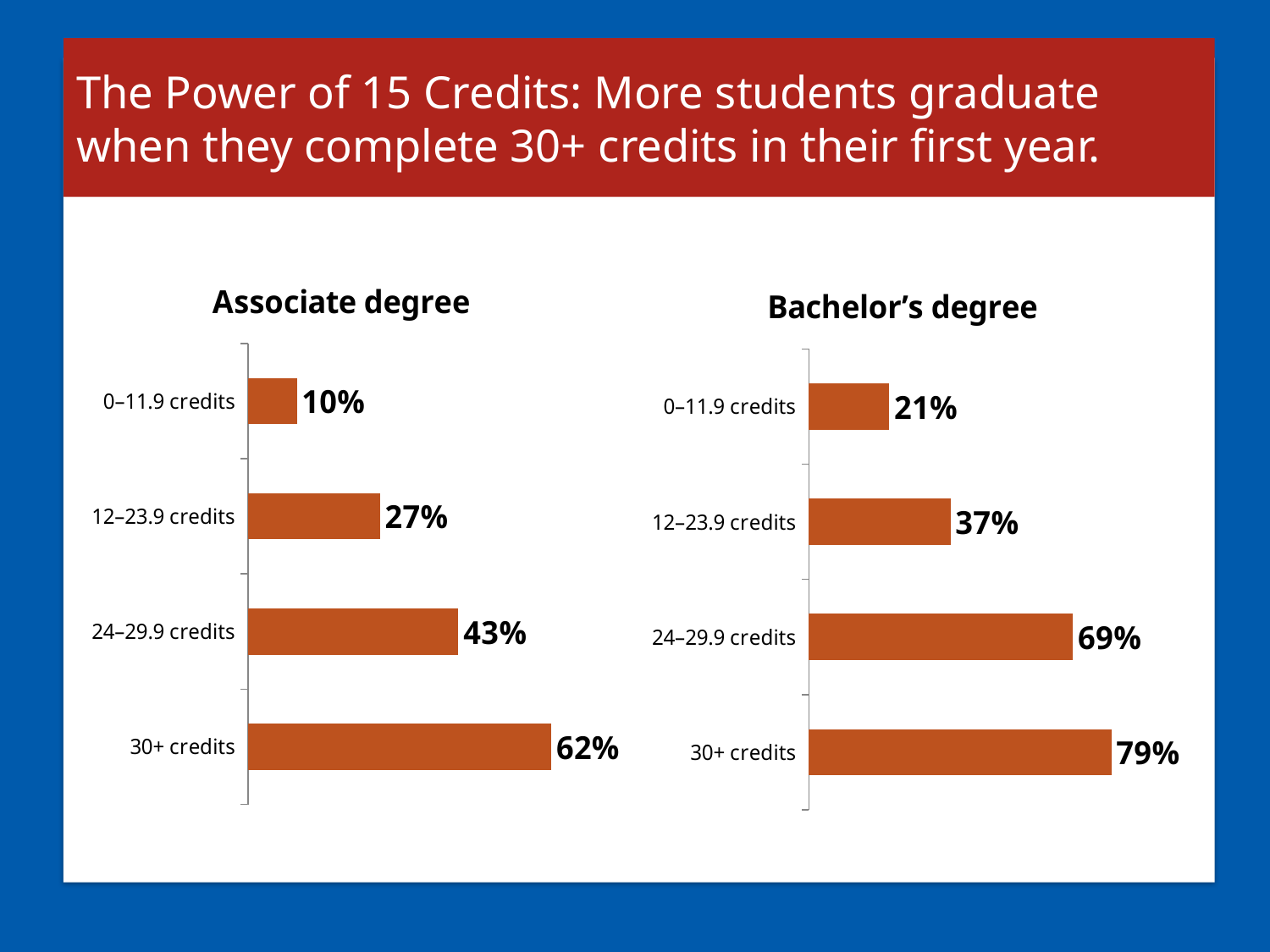
In the Bachelor's degree chart, what is the value for 12–23.9 credits? 37% In the Bachelor's degree chart, what is the difference between the values for 30+ credits and 0–11.9 credits? 58% In the Associate degree chart, what is the difference between the values for 24–29.9 credits and 12–23.9 credits? 16% In the Associate degree chart, which category has the lowest value? 0–11.9 credits In the Bachelor's degree chart, which category has the highest value? 30+ credits How many categories are shown in the Associate degree chart? 4 What kind of chart is the Bachelor's degree chart? Bar chart In the Associate degree chart, what is the value for 30+ credits? 62% Which is larger: the value for 24–29.9 credits in the Bachelor's degree chart or the value for 30+ credits in the Associate degree chart? 24–29.9 credits in the Bachelor's degree chart In the Associate degree chart, what is the value for 0–11.9 credits? 10% In the Bachelor's degree chart, do the values rise or fall as the credit categories go from 0–11.9 credits to 30+ credits? Rise What is the title of the chart on the left side of the slide? Associate degree